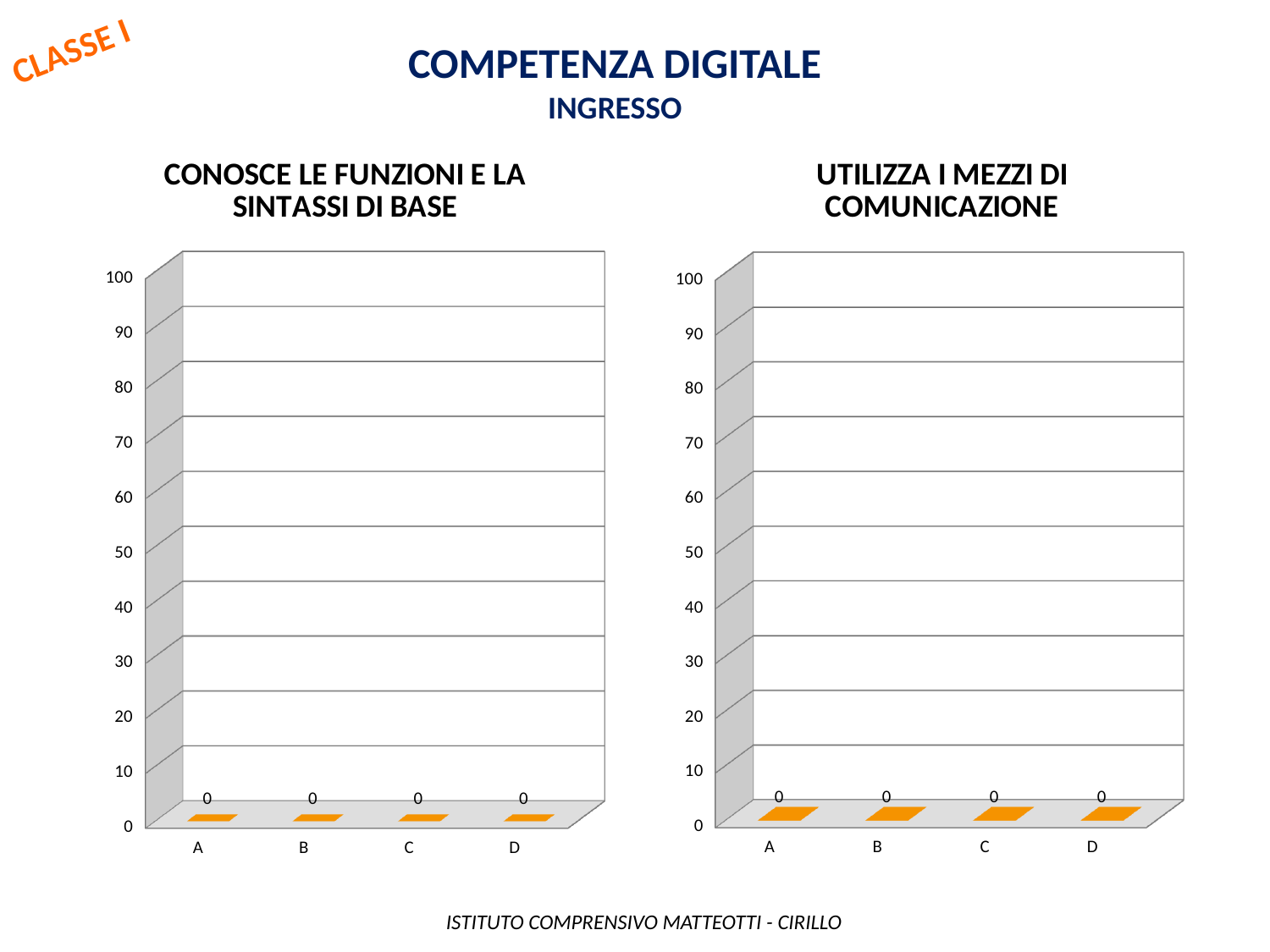
In the chart titled "CONOSCE LE FUNZIONI E LA SINTASSI DI BASE", what is the highest value shown on the vertical axis? 100 In the chart titled "UTILIZZA I MEZZI DI COMUNICAZIONE", is the value for D greater or less than 10? less In the chart titled "UTILIZZA I MEZZI DI COMUNICAZIONE", how many categories are shown on the x axis? 4 What is the title of the chart on the right side of the slide? UTILIZZA I MEZZI DI COMUNICAZIONE In the chart titled "UTILIZZA I MEZZI DI COMUNICAZIONE", what is the value for category C? 0 In the chart titled "CONOSCE LE FUNZIONI E LA SINTASSI DI BASE", how many categories are shown on the x axis? 4 In the chart titled "CONOSCE LE FUNZIONI E LA SINTASSI DI BASE", what is the value for category A? 0 In the chart titled "CONOSCE LE FUNZIONI E LA SINTASSI DI BASE", what is the value for category D? 0 What kind of chart is the chart titled "UTILIZZA I MEZZI DI COMUNICAZIONE"? Bar chart In the chart titled "CONOSCE LE FUNZIONI E LA SINTASSI DI BASE", what is the difference between the values for A and C? 0 In the chart titled "UTILIZZA I MEZZI DI COMUNICAZIONE", what is the value for category B? 0 What kind of chart is the chart titled "CONOSCE LE FUNZIONI E LA SINTASSI DI BASE"? Bar chart